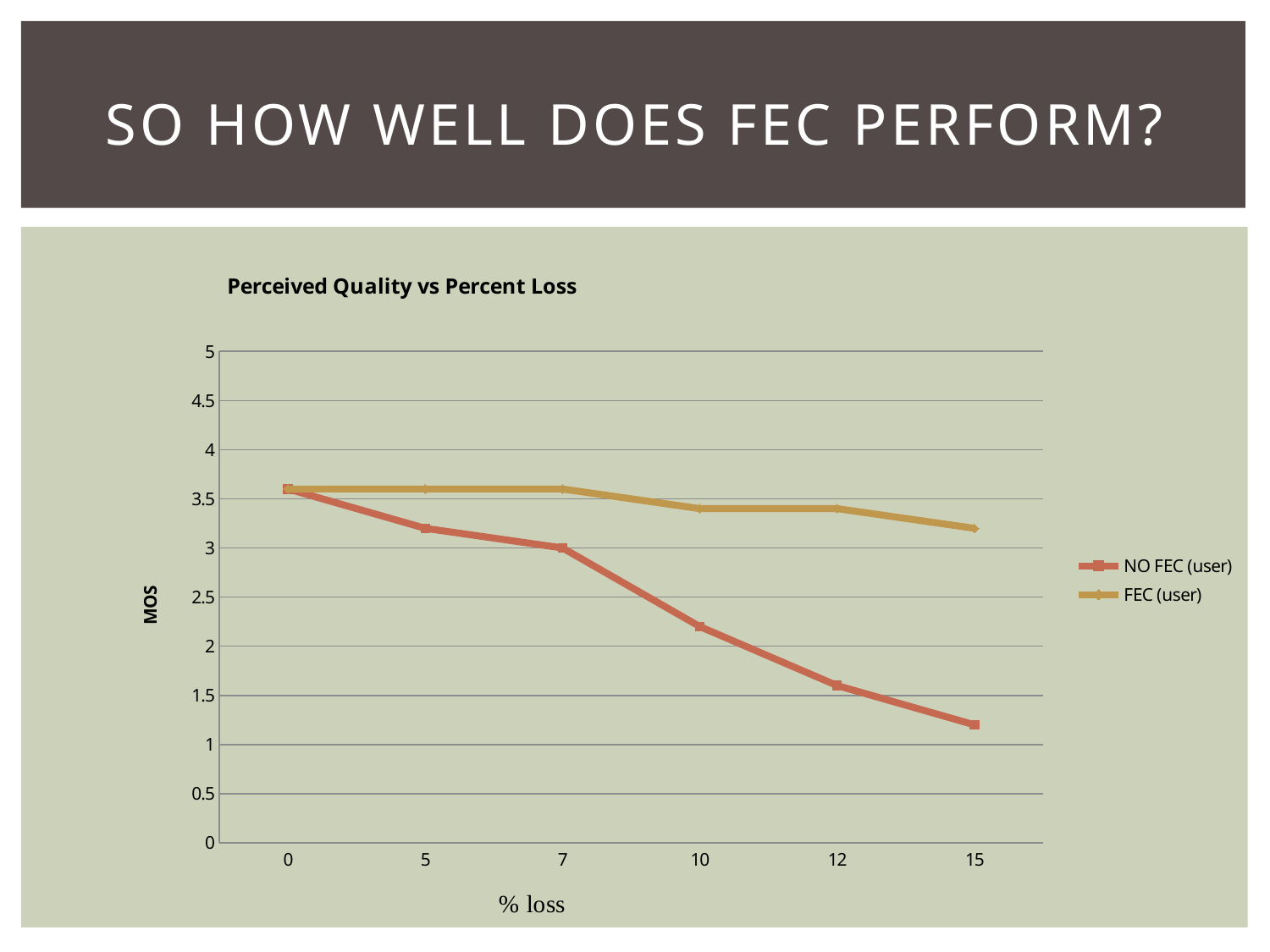
Is the value for NO FEC (user) at 10% loss greater or less than 2? greater Is the value for FEC (user) at 15% loss greater or less than 3? greater What is the label of the y axis? MOS Is the value for FEC (user) at 0% loss greater or less than 3.5? greater What is the title of the chart? Perceived Quality vs Percent Loss How many points are plotted along the x axis for each series? 6 What is the MOS value for NO FEC (user) at 7% loss? 3 At 10% loss, which series has the higher MOS value, NO FEC (user) or FEC (user)? FEC (user) Does the NO FEC (user) series rise or fall as % loss increases? fall What kind of chart is shown on the slide? line chart How many series does the legend list? 2